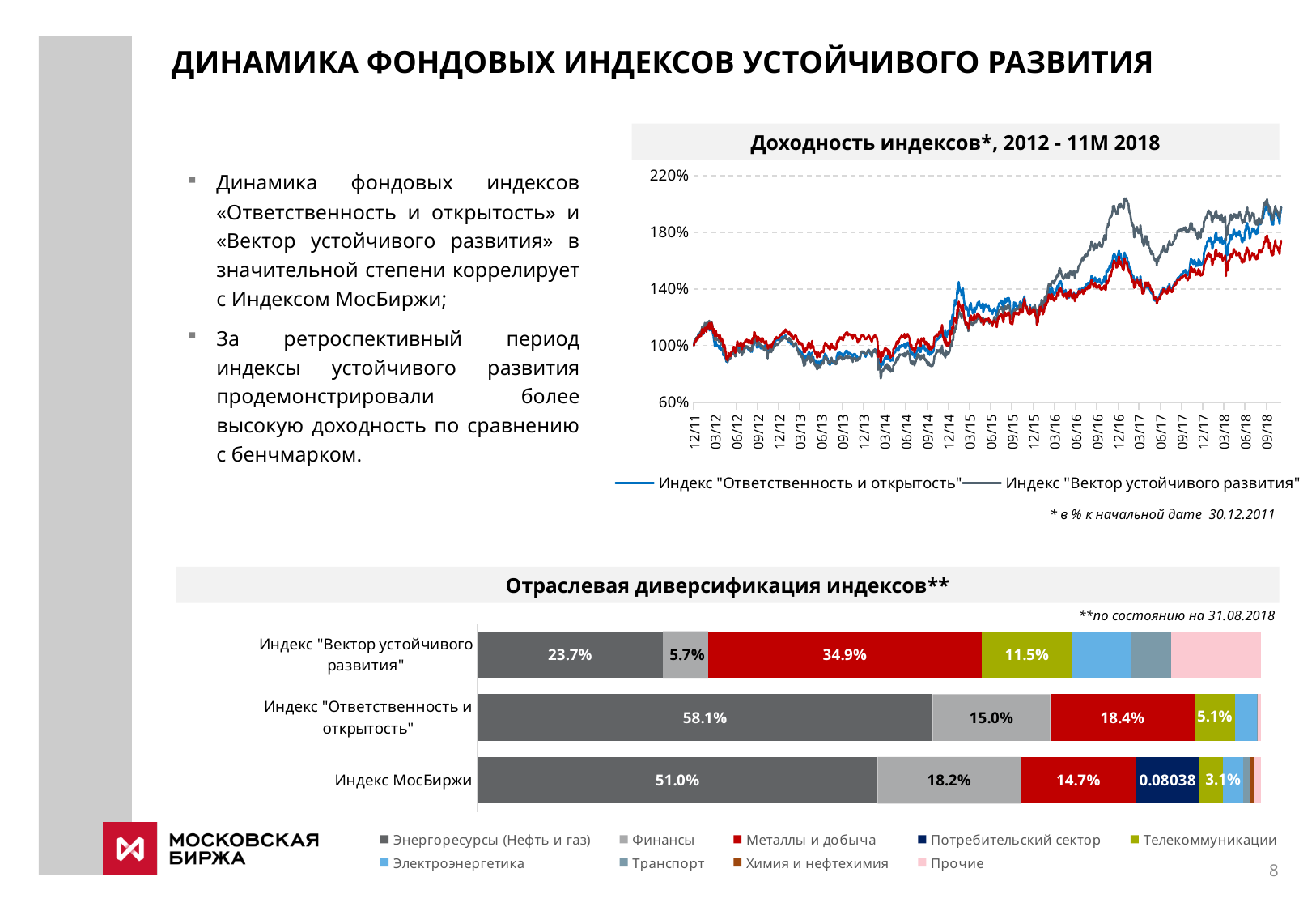
In the bottom chart "Отраслевая диверсификация индексов**", what is the share of Финансы in Индекс МосБиржи? 18.2% How many sectors does the legend of the bottom chart "Отраслевая диверсификация индексов**" list? 9 In the bottom chart "Отраслевая диверсификация индексов**", which index has the largest share of Энергоресурсы (Нефть и газ)? Индекс "Ответственность и открытость" How many indices are shown as bars in the bottom chart "Отраслевая диверсификация индексов**"? 3 In the bottom chart "Отраслевая диверсификация индексов**", what is the share of Энергоресурсы (Нефть и газ) in Индекс "Вектор устойчивого развития"? 23.7% In the bottom chart "Отраслевая диверсификация индексов**", what is the share of Телекоммуникации in Индекс МосБиржи? 3.1% In the bottom chart "Отраслевая диверсификация индексов**", by how many percentage points does the Энергоресурсы (Нефть и газ) share of Индекс "Ответственность и открытость" exceed that of Индекс МосБиржи? 7.1 percentage points In the bottom chart "Отраслевая диверсификация индексов**", what is the share of Металлы и добыча in Индекс "Ответственность и открытость"? 18.4% What kind of chart is the top chart titled "Доходность индексов*, 2012 - 11M 2018"? line chart In the bottom chart "Отраслевая диверсификация индексов**", which index has the larger share of Металлы и добыча: Индекс "Вектор устойчивого развития" or Индекс "Ответственность и открытость"? Индекс "Вектор устойчивого развития" What kind of chart is the bottom chart titled "Отраслевая диверсификация индексов**"? bar chart In the top chart "Доходность индексов*, 2012 - 11M 2018", is the value of Индекс "Вектор устойчивого развития" at the end of the period (09/18) greater or less than 180%? greater